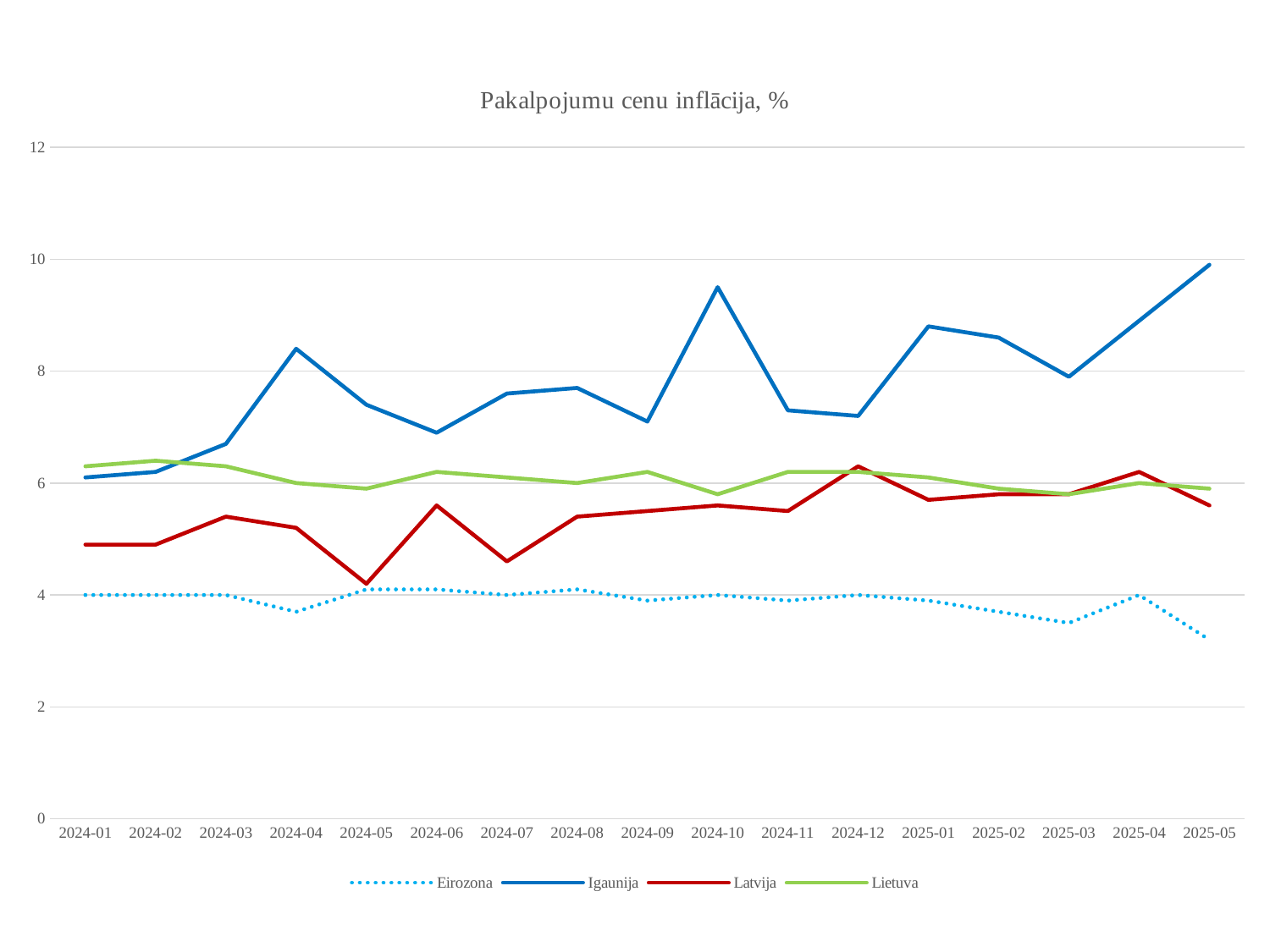
Is the value for Eirozona in 2025-05 greater or less than 4? less Is the value for Igaunija in 2024-10 greater or less than 8? greater Does the Igaunija line overall rise or fall from 2024-01 to 2025-05? rise What is the title of the chart? Pakalpojumu cenu inflācija, % Which series is drawn with a dotted line? Eirozona How many months are shown along the x axis? 17 How many series does the legend list? 4 Which series has the highest value in 2025-05? Igaunija In 2024-10, which is larger: Igaunija or Latvija? Igaunija Which series has the lowest values across the whole period? Eirozona Is the value for Latvija in 2024-01 greater or less than 6? less What kind of chart is shown on the slide? line chart